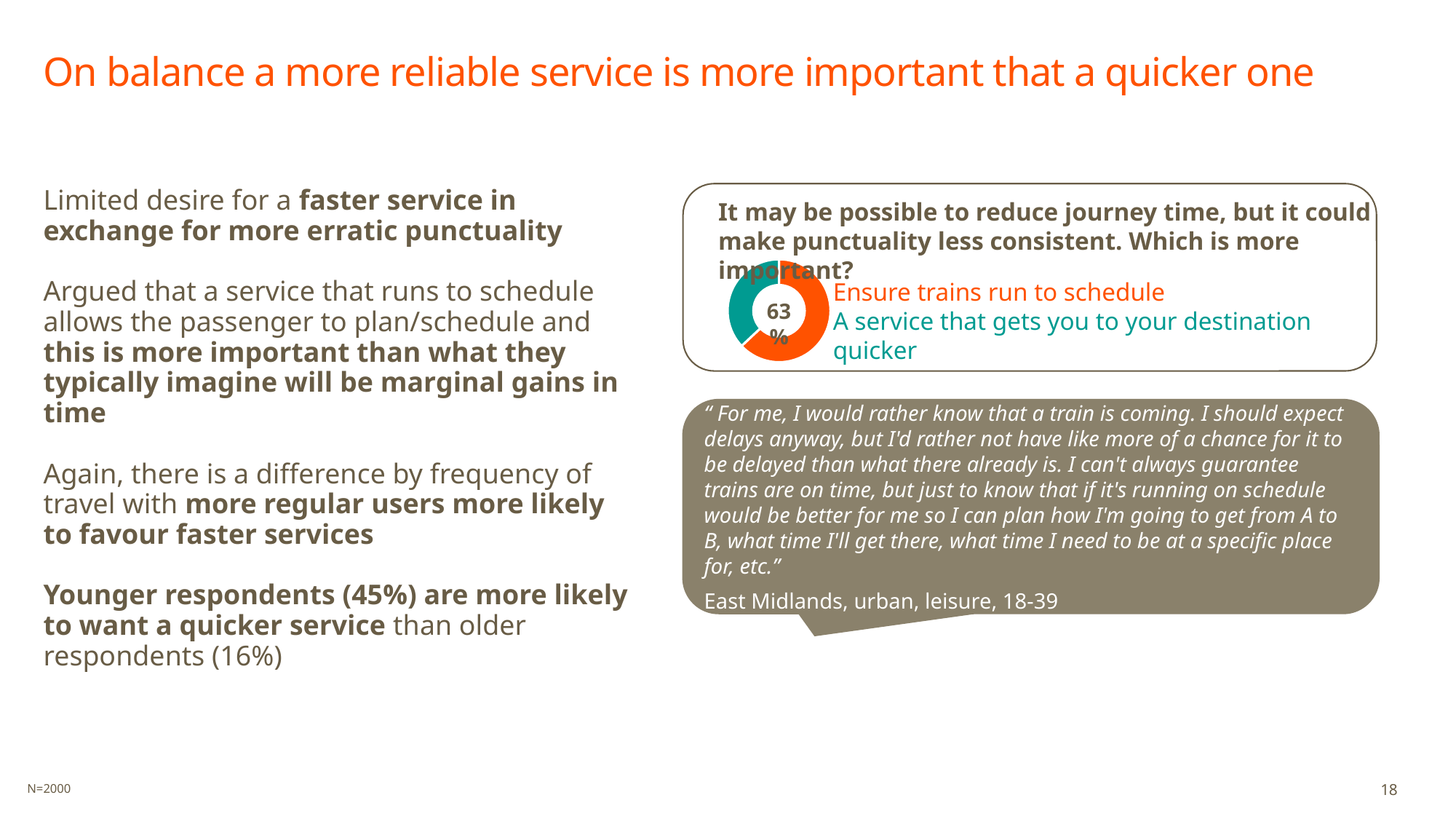
What kind of chart is shown on the slide? Donut (pie) chart What colour represents 'Ensure trains run to schedule' in the donut chart? Orange Is the share for 'Ensure trains run to schedule' greater or less than 50%? greater What colour represents 'A service that gets you to your destination quicker' in the donut chart? Teal Which category takes the larger share of the donut chart? Ensure trains run to schedule Is the share for 'A service that gets you to your destination quicker' greater or less than 50%? less Which category takes the smaller share of the donut chart? A service that gets you to your destination quicker How many categories does the donut chart show? 2 What percentage is printed in the centre of the donut chart? 63% Which is larger in the donut chart: the share for 'Ensure trains run to schedule' or the share for 'A service that gets you to your destination quicker'? Ensure trains run to schedule